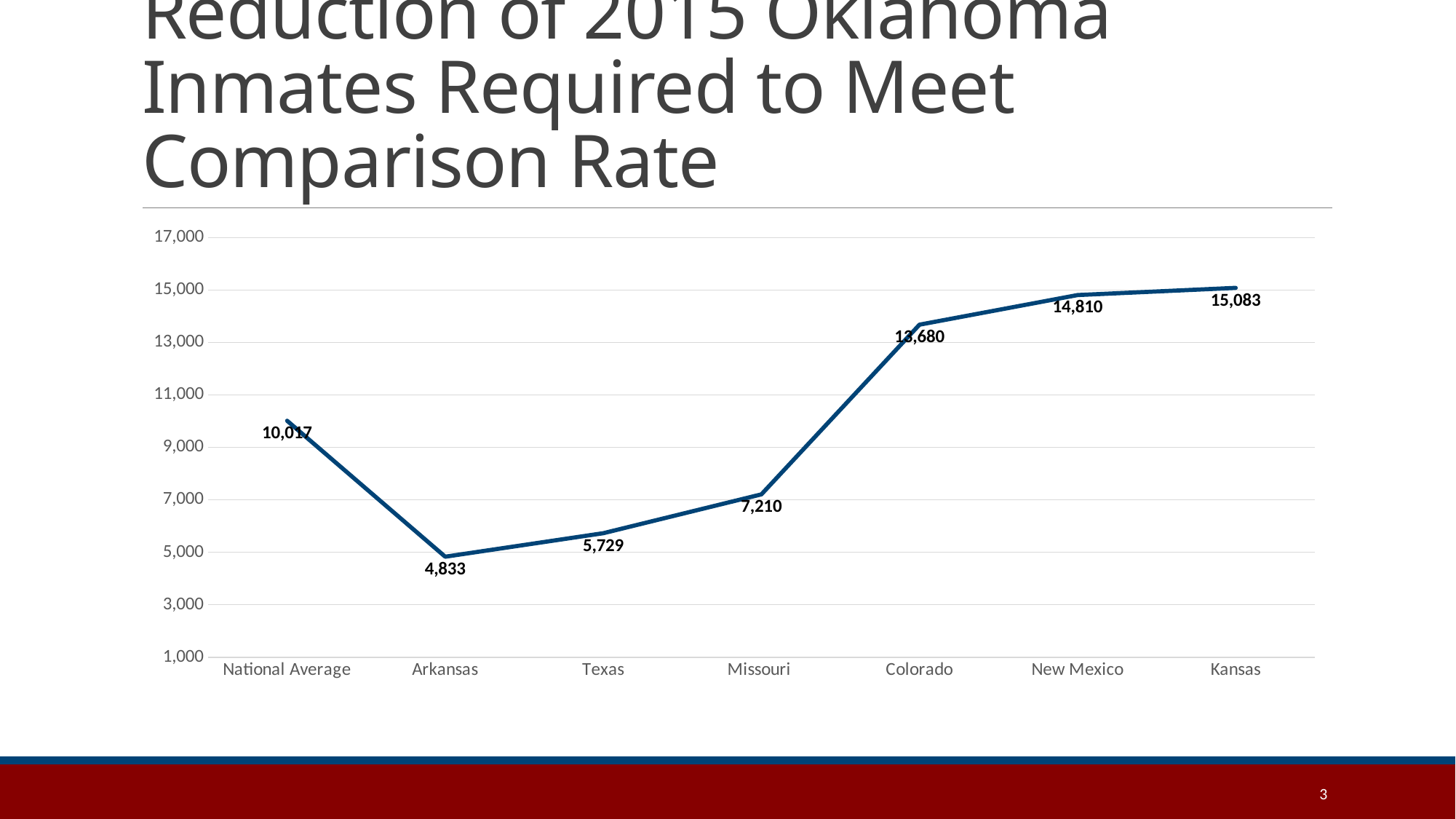
What is the difference between the values for Colorado and Missouri? 6,470 Which category has the highest value? Kansas What is the value for Arkansas? 4,833 What kind of chart is shown on the slide? line chart What is the value for the National Average? 10,017 Which category has the lowest value? Arkansas What is the value for Colorado? 13,680 Which is larger, the value for Texas or the value for Missouri? Missouri What is the difference between the values for Kansas and Arkansas? 10,250 Is the value for New Mexico greater or less than 13,000? greater Do the values rise or fall from Arkansas to Kansas along the x axis? rise How many categories are shown on the x axis? 7